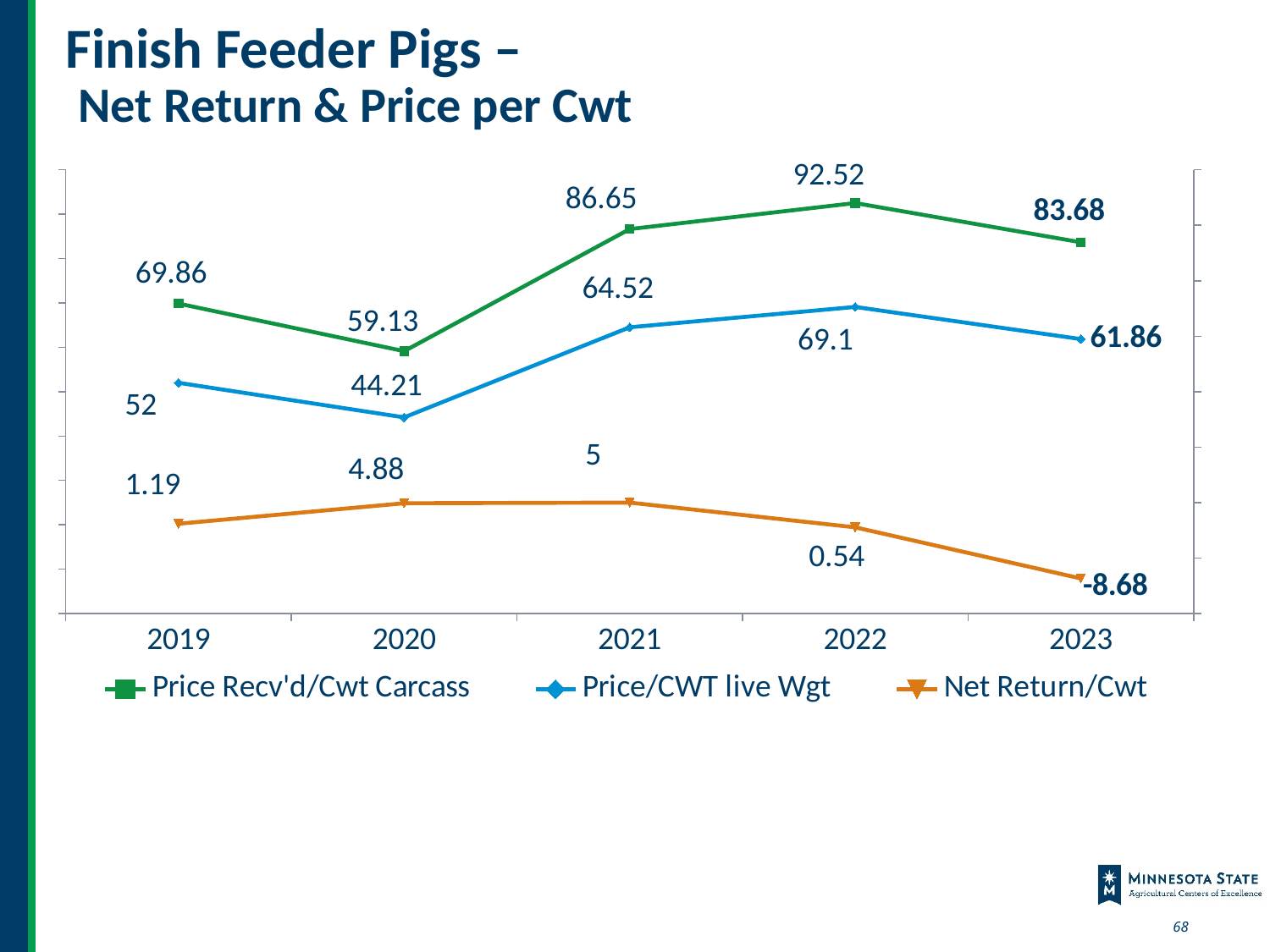
In which year is Net Return/Cwt lowest? 2023 What is the Net Return/Cwt value for 2023? -8.68 How many series does the legend list? 3 What is the title of the chart on the slide? Finish Feeder Pigs – Net Return & Price per Cwt What is the difference between Price Recv'd/Cwt Carcass and Price/CWT live Wgt in 2021? 22.13 How many years are plotted along the x axis? 5 What is the Price/CWT live Wgt value for 2020? 44.21 What is the Price Recv'd/Cwt Carcass value for 2022? 92.52 What type of chart is shown on the slide? Line chart Does Net Return/Cwt rise or fall from 2021 to 2023? Fall In which year is Price Recv'd/Cwt Carcass highest? 2022 Which is larger, the Net Return/Cwt in 2020 or in 2022? 2020